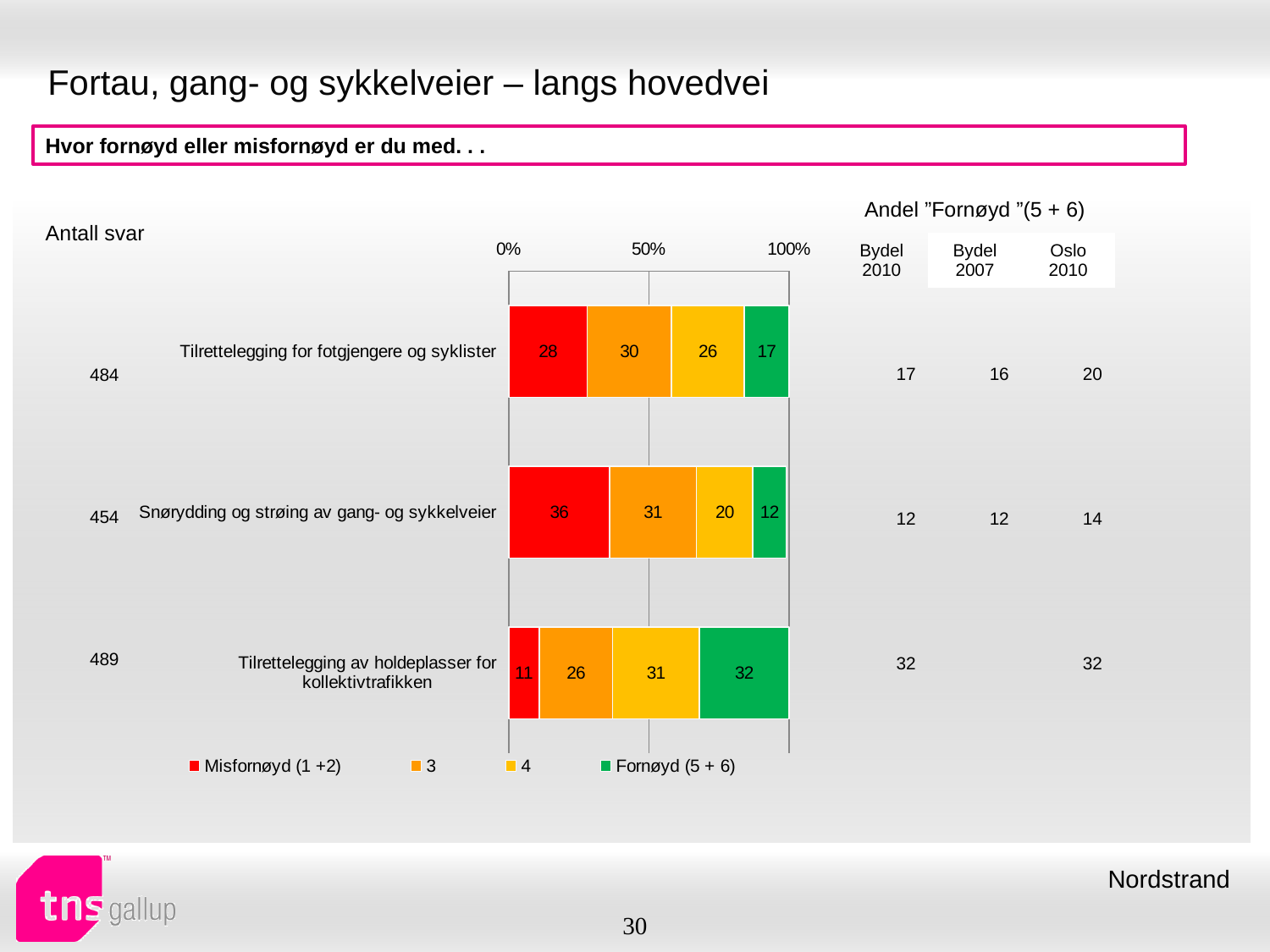
How many series does the chart legend list? 4 Which category has the lowest Fornøyd (5 + 6) value? Snørydding og strøing av gang- og sykkelveier What is the total of the stacked bar for "Tilrettelegging av holdeplasser for kollektivtrafikken"? 100 Which colour represents the Fornøyd (5 + 6) series in the chart? green Which category has the highest Misfornøyd (1 +2) value? Snørydding og strøing av gang- og sykkelveier What is the value of the "4" segment for "Tilrettelegging for fotgjengere og syklister"? 26 What is the value of the Fornøyd (5 + 6) segment for "Tilrettelegging av holdeplasser for kollektivtrafikken"? 32 What is the difference between the Misfornøyd (1 +2) values for "Snørydding og strøing av gang- og sykkelveier" and "Tilrettelegging av holdeplasser for kollektivtrafikken"? 25 Which is larger: the Fornøyd (5 + 6) value for "Tilrettelegging for fotgjengere og syklister" or for "Tilrettelegging av holdeplasser for kollektivtrafikken"? Tilrettelegging av holdeplasser for kollektivtrafikken How many categories are plotted in the chart? 3 What type of chart is shown on the slide? stacked bar chart What is the value of the Misfornøyd (1 +2) segment for "Snørydding og strøing av gang- og sykkelveier"? 36